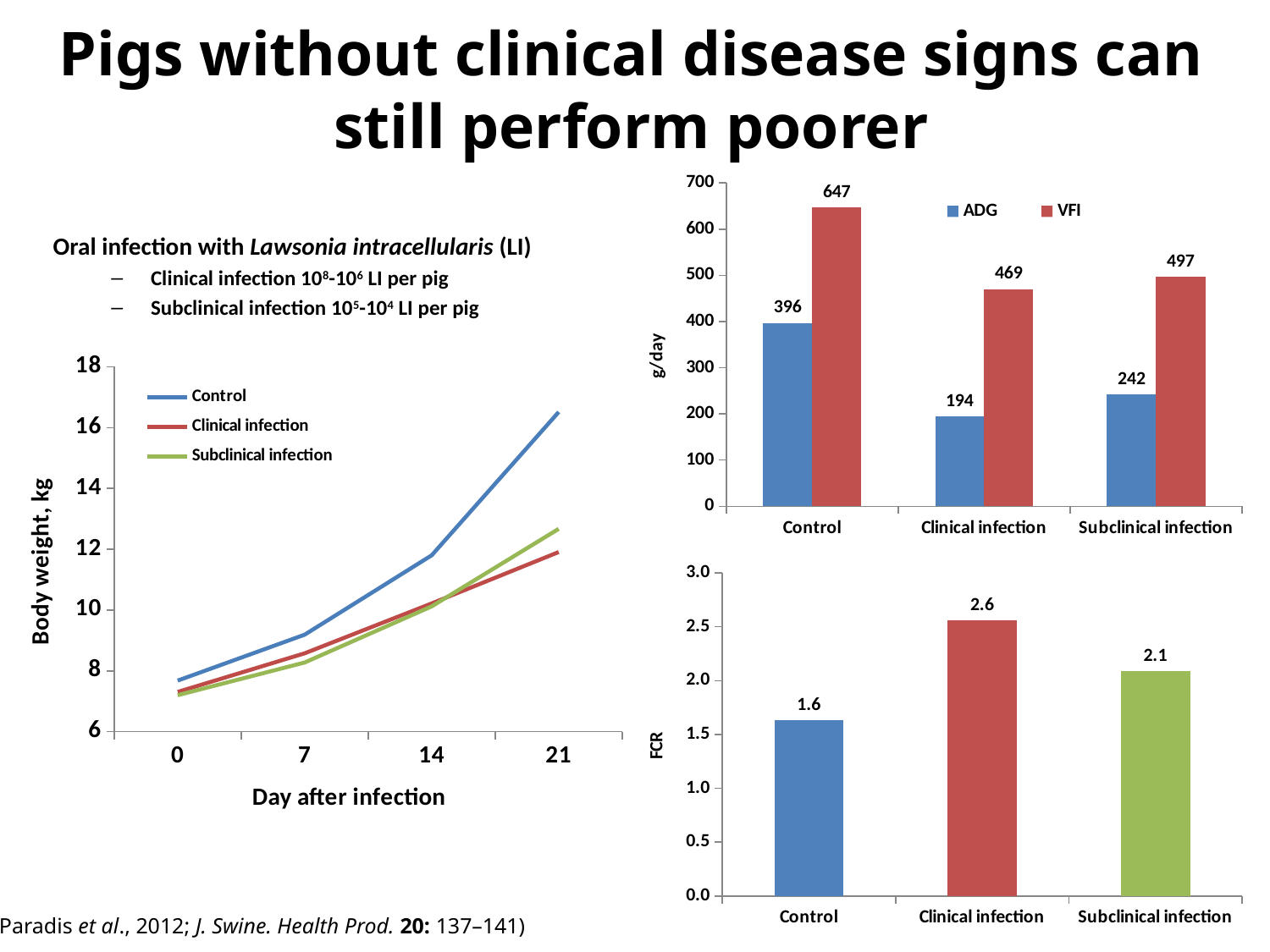
In the bottom-right FCR bar chart, how many groups are shown on the x axis? 3 In the top-right g/day bar chart, which group has the lowest ADG? Clinical infection In the body weight line chart on the left, how many series does the legend list? 3 In the top-right g/day bar chart, how many series does the legend list? 2 What kind of chart is the body weight chart on the left of the slide? Line chart In the bottom-right FCR bar chart, is the FCR for Subclinical infection greater or less than the FCR for Control? greater In the top-right g/day bar chart, what is the VFI value for Subclinical infection? 497 In the bottom-right FCR bar chart, which group has the lowest FCR? Control In the bottom-right FCR bar chart, what is the FCR value for Clinical infection? 2.6 In the body weight line chart on the left, is the Control body weight at day 21 greater or less than 16 kg? greater In the top-right g/day bar chart, what is the difference between the VFI values for Control and Clinical infection? 178 In the top-right g/day bar chart, what is the ADG value for Control? 396